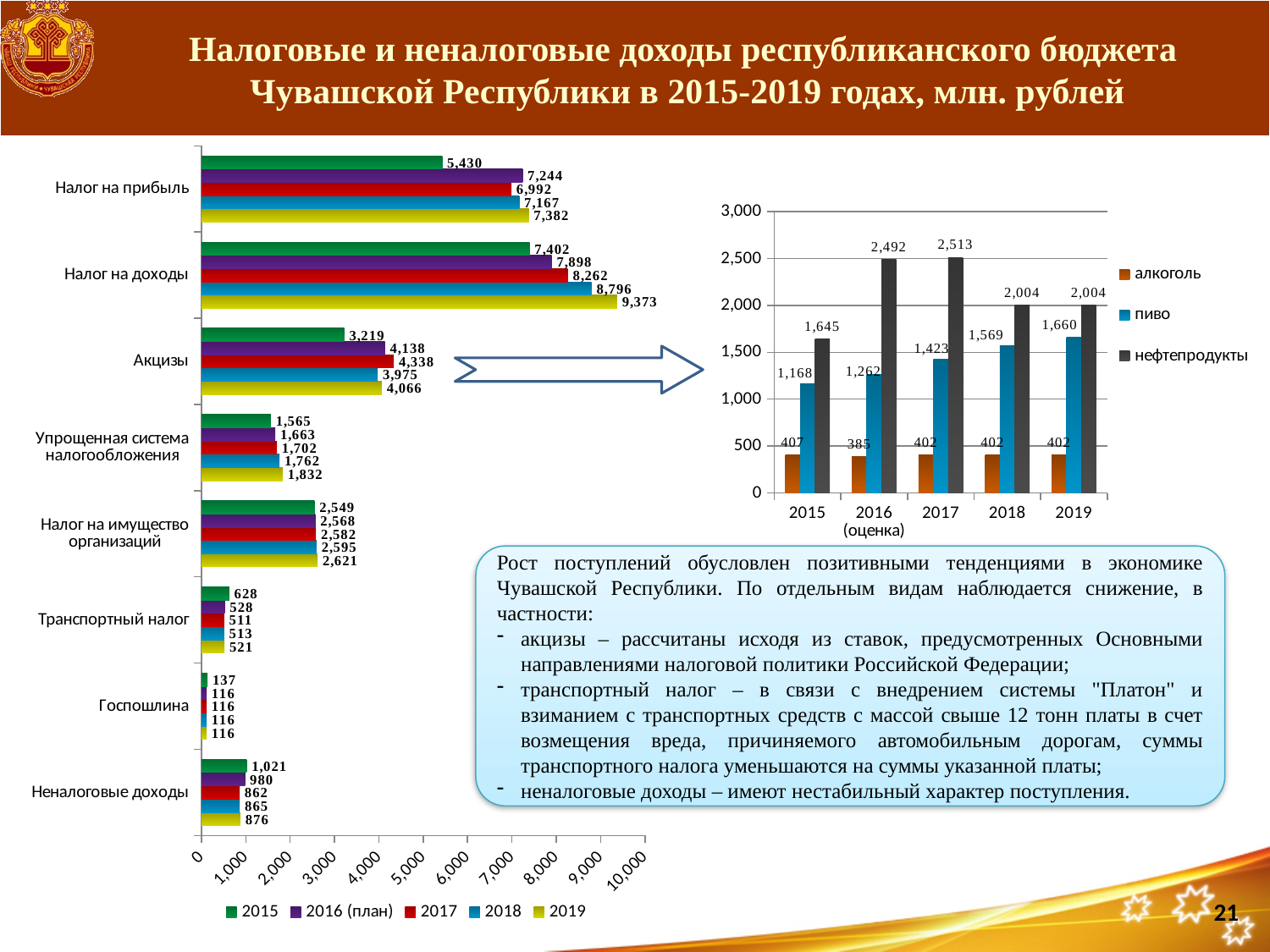
On the left chart, what is the difference between the 2019 and 2015 values for Налог на доходы? 1,971 On the right chart, what is the difference between the нефтепродукты values for 2016 and 2015? 847 On the right chart, in which year is the value for нефтепродукты highest? 2017 On the right chart, what is the value for пиво in 2018? 1,569 On the right chart, do the values for пиво rise or fall from 2015 to 2019? rise On the left chart, which category has the highest value for 2019? Налог на доходы On the left chart, how many categories are shown? 8 On the left chart, which is larger for Транспортный налог: the 2015 value or the 2019 value? 2015 On the left chart, which category has the lowest value for 2015? Госпошлина On the left chart, how many series does the legend list? 5 On the left chart, what is the value for Акцизы in 2017? 4,338 On the left chart, what is the value for Налог на доходы in 2019? 9,373